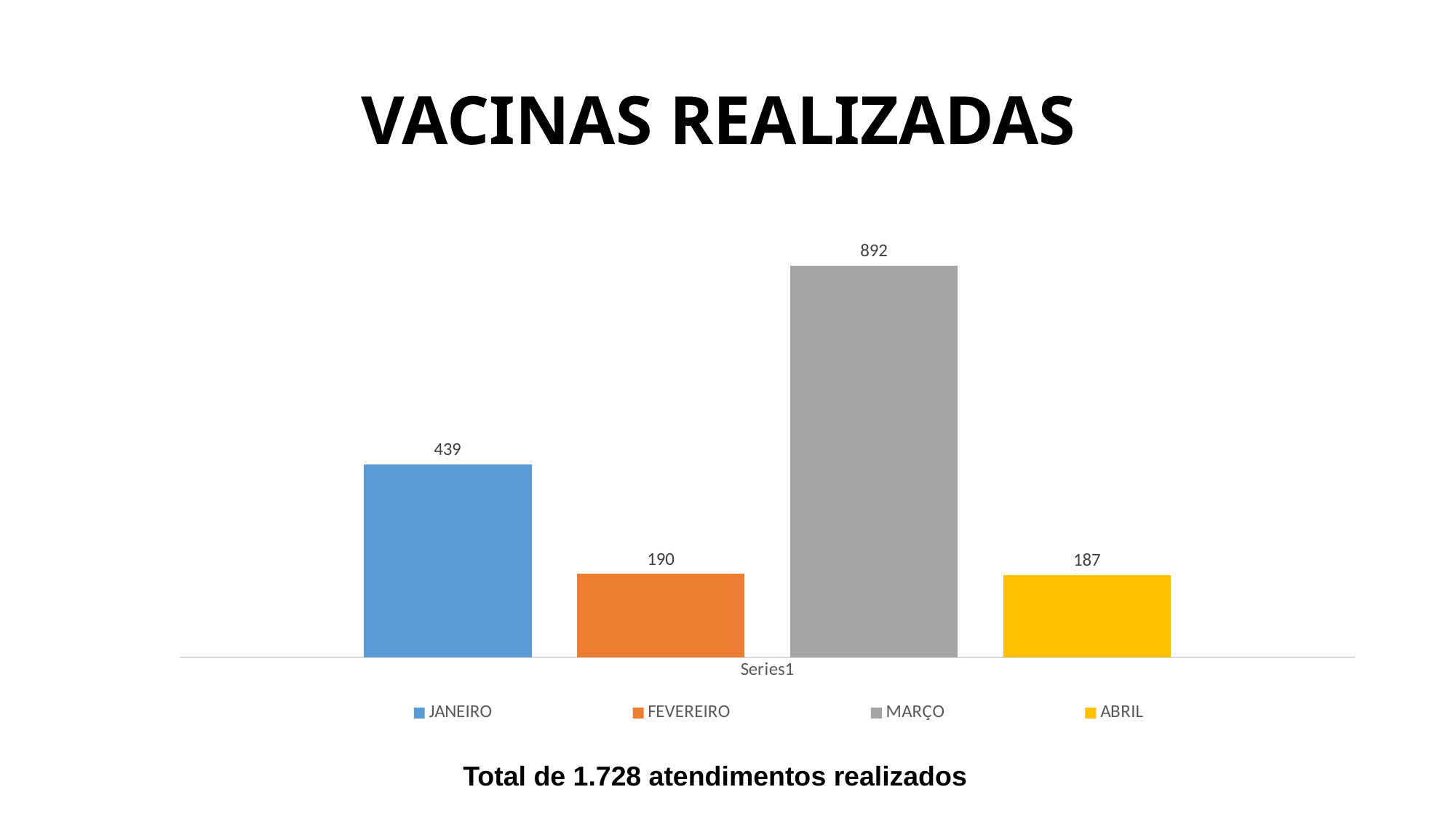
What is the value for FEVEREIRO? 190 Which month has the lowest value? ABRIL Which is larger, the value for JANEIRO or the value for FEVEREIRO? JANEIRO What kind of chart is shown? Bar chart What is the difference between the values for MARÇO and JANEIRO? 453 What is the value for MARÇO? 892 What is the value for ABRIL? 187 What is the title of the chart? VACINAS REALIZADAS Which month has the highest value? MARÇO How many series does the legend list? 4 What is the value for JANEIRO? 439 What is the difference between the values for FEVEREIRO and ABRIL? 3